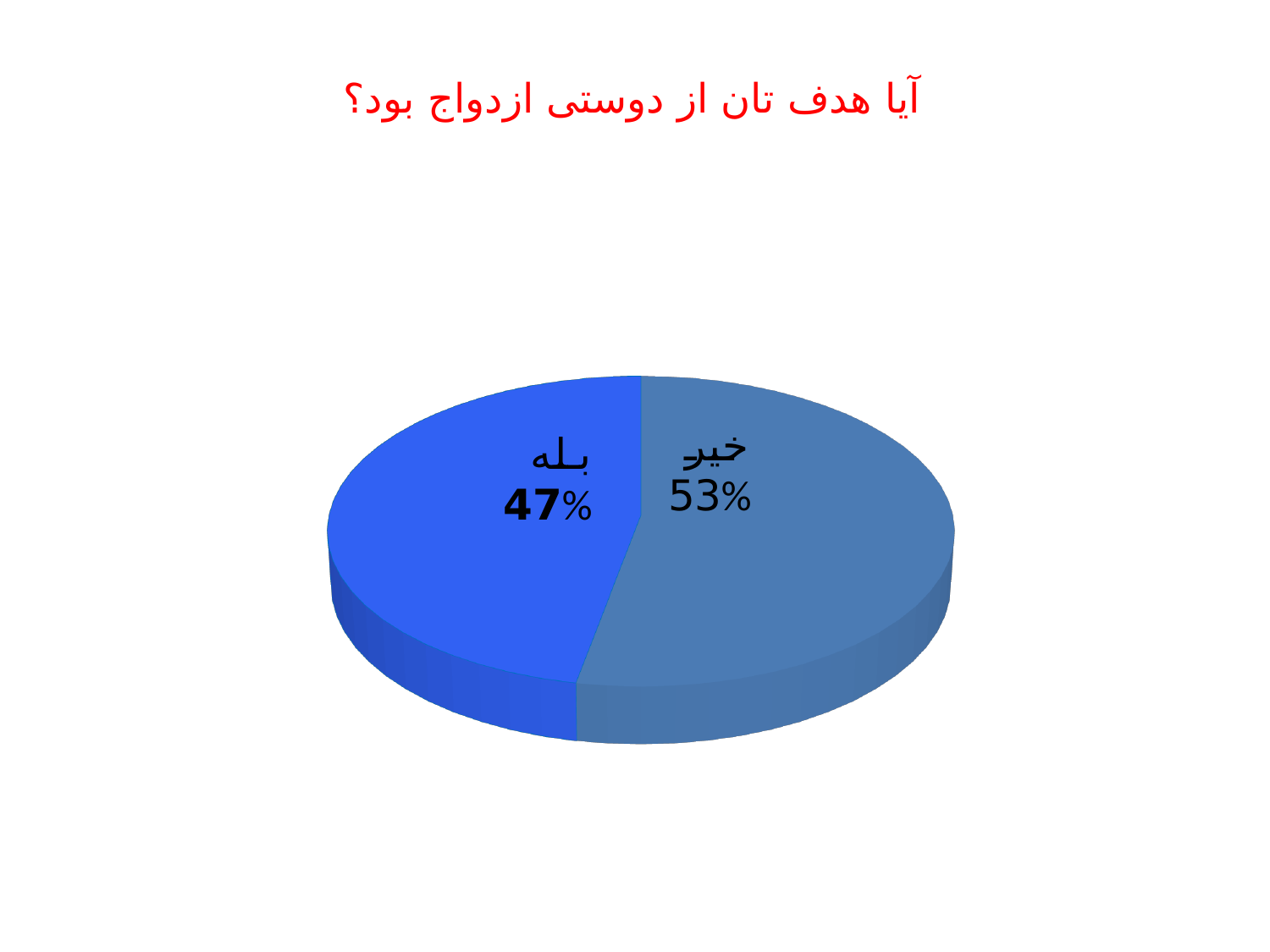
What kind of chart is shown on the slide? Pie chart How many slices does the pie chart have? 2 Which slice of the pie is the smallest? بله Which slice of the pie is the largest? خیر What is the difference in percentage points between the "خیر" slice and the "بله" slice? 6 What percentage of the pie is labelled "بله"? 47% Is the share for "بله" greater or less than 50%? less What percentage of the pie is labelled "خیر"? 53% Which is larger, the "بله" slice or the "خیر" slice? خیر What share of the pie does the "خیر" slice represent? 53% What is the total of the two slice percentages shown? 100% What is the title of the chart? آیا هدف تان از دوستی ازدواج بود؟